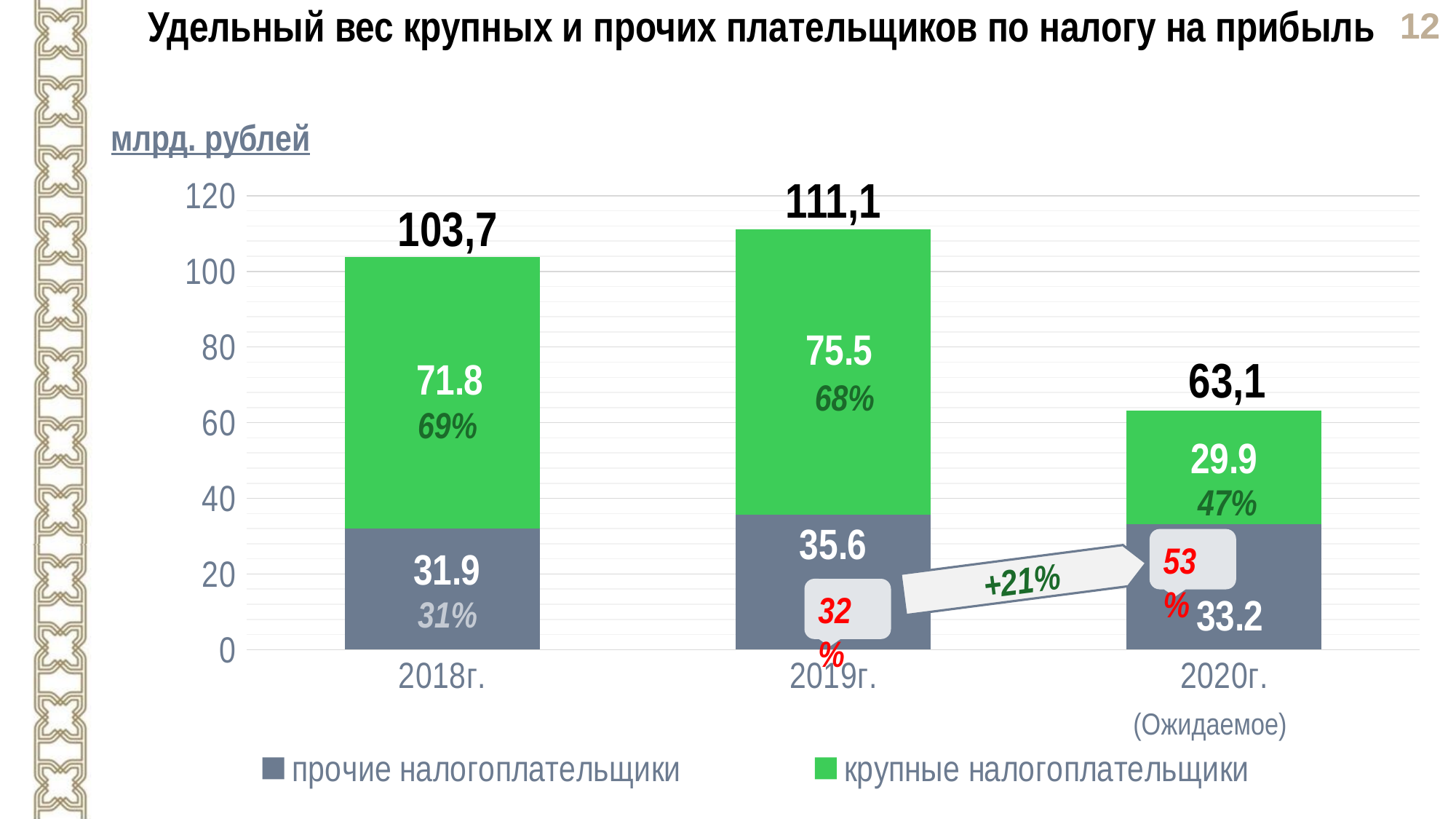
What is the value for крупные налогоплательщики in 2020г. (Ожидаемое)? 29.9 What is the difference between the крупные налогоплательщики values for 2019г. and 2018г.? 3.7 What is the total of the stacked bar for 2020г. (Ожидаемое)? 63,1 What is the total of the stacked bar for 2019г.? 111,1 Which is larger in 2020г. (Ожидаемое): прочие налогоплательщики or крупные налогоплательщики? прочие налогоплательщики What is the value for крупные налогоплательщики in 2018г.? 71.8 Which year has the highest total value? 2019г. What share of the 2018г. bar do крупные налогоплательщики account for, as labelled on the chart? 69% Which year has the lowest total value? 2020г. (Ожидаемое) What is the value for прочие налогоплательщики in 2019г.? 35.6 What type of chart is shown on the slide? stacked bar chart How many series does the legend list? 2